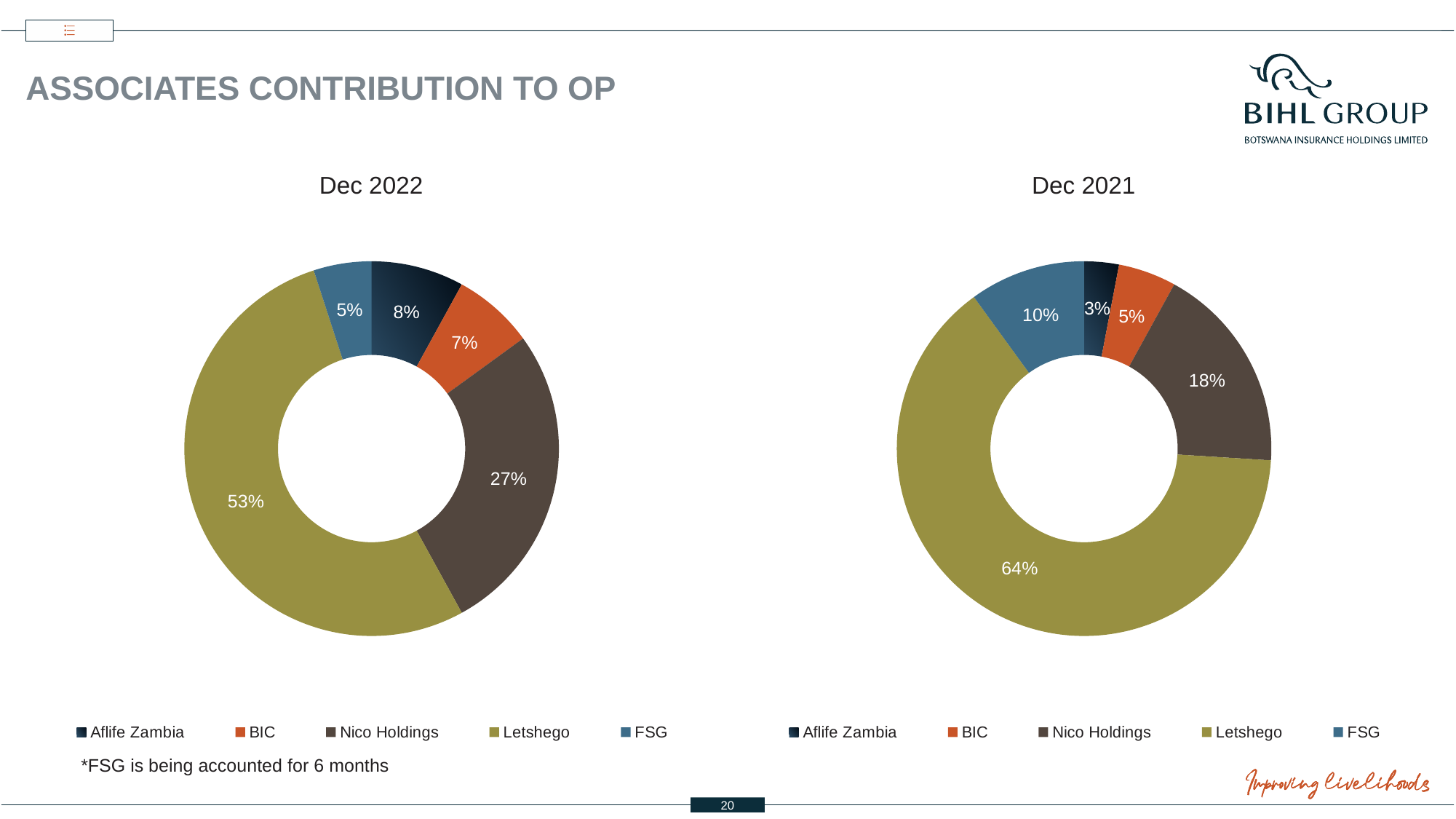
In the Dec 2022 chart, which colour represents Nico Holdings? Brown In the Dec 2021 chart, which associate has the largest share? Letshego In the Dec 2021 chart, which is larger, the FSG share or the BIC share? FSG In the Dec 2022 chart, what is the value for FSG? 5% How many categories does the Dec 2022 chart show? 5 What kind of chart is the Dec 2021 chart? Doughnut (pie) chart What is the title of the chart on the left of the slide? Dec 2022 In the Dec 2021 chart, what share does Nico Holdings contribute? 18% In the Dec 2022 chart, what share does Letshego contribute? 53% In the Dec 2021 chart, what is the value for Aflife Zambia? 3% In the Dec 2022 chart, what is the difference between the Nico Holdings share and the BIC share? 20% In the Dec 2022 chart, which associate has the smallest share? FSG